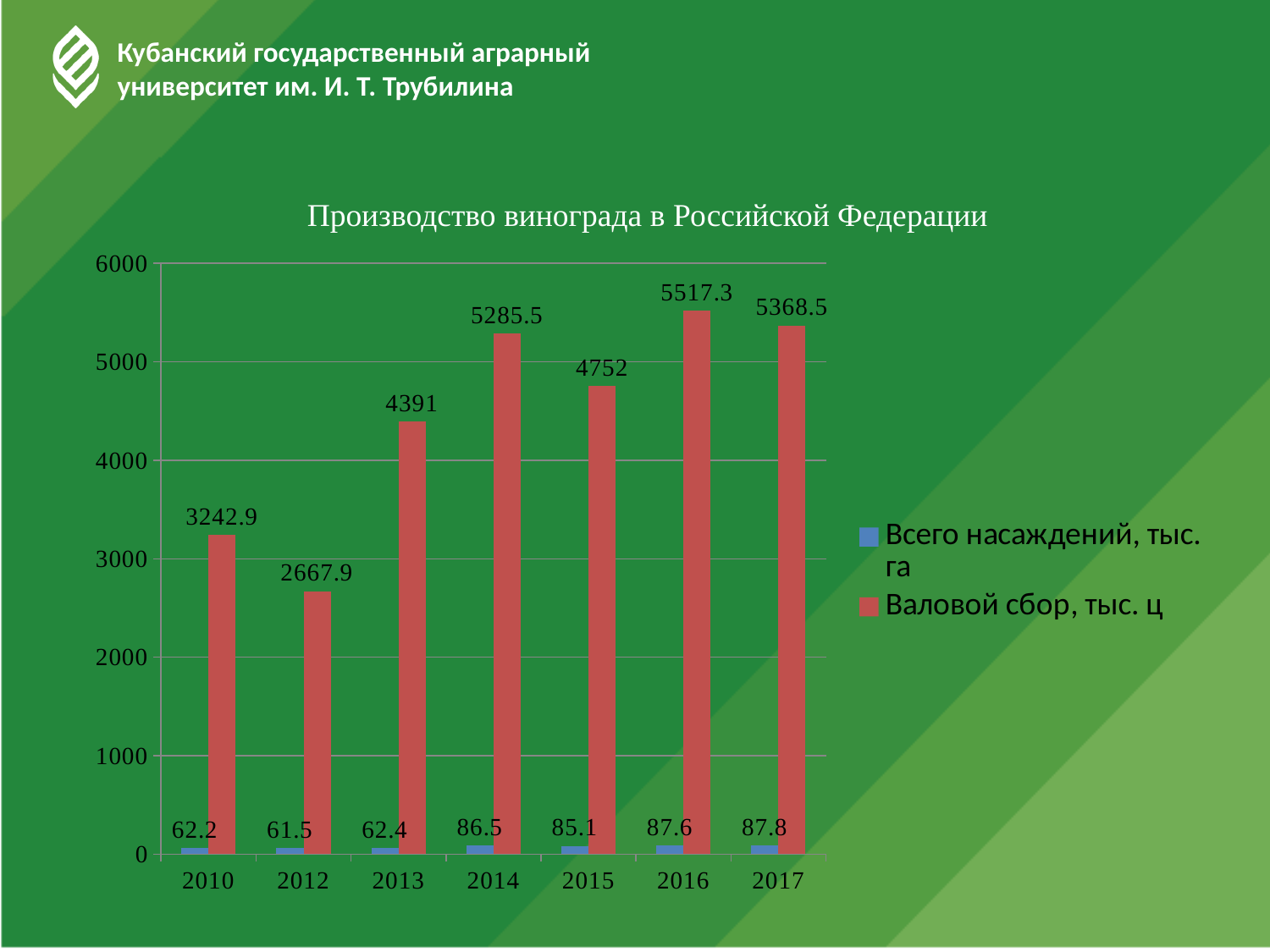
What kind of chart is shown on the slide? bar chart Which year has the highest Валовой сбор, тыс. ц? 2016 How many years are shown on the x axis? 7 Which is larger, Валовой сбор, тыс. ц in 2013 or in 2015? 2015 What is the value of Валовой сбор, тыс. ц for 2012? 2667.9 What is the value of Всего насаждений, тыс. га for 2010? 62.2 What is the difference in Валовой сбор, тыс. ц between 2016 and 2017? 148.8 How many series does the legend list? 2 What is the value of Валовой сбор, тыс. ц for 2014? 5285.5 What is the title of the chart? Производство винограда в Российской Федерации Is the value of Валовой сбор, тыс. ц for 2010 greater or less than 3000? greater Which year has the lowest Всего насаждений, тыс. га? 2012